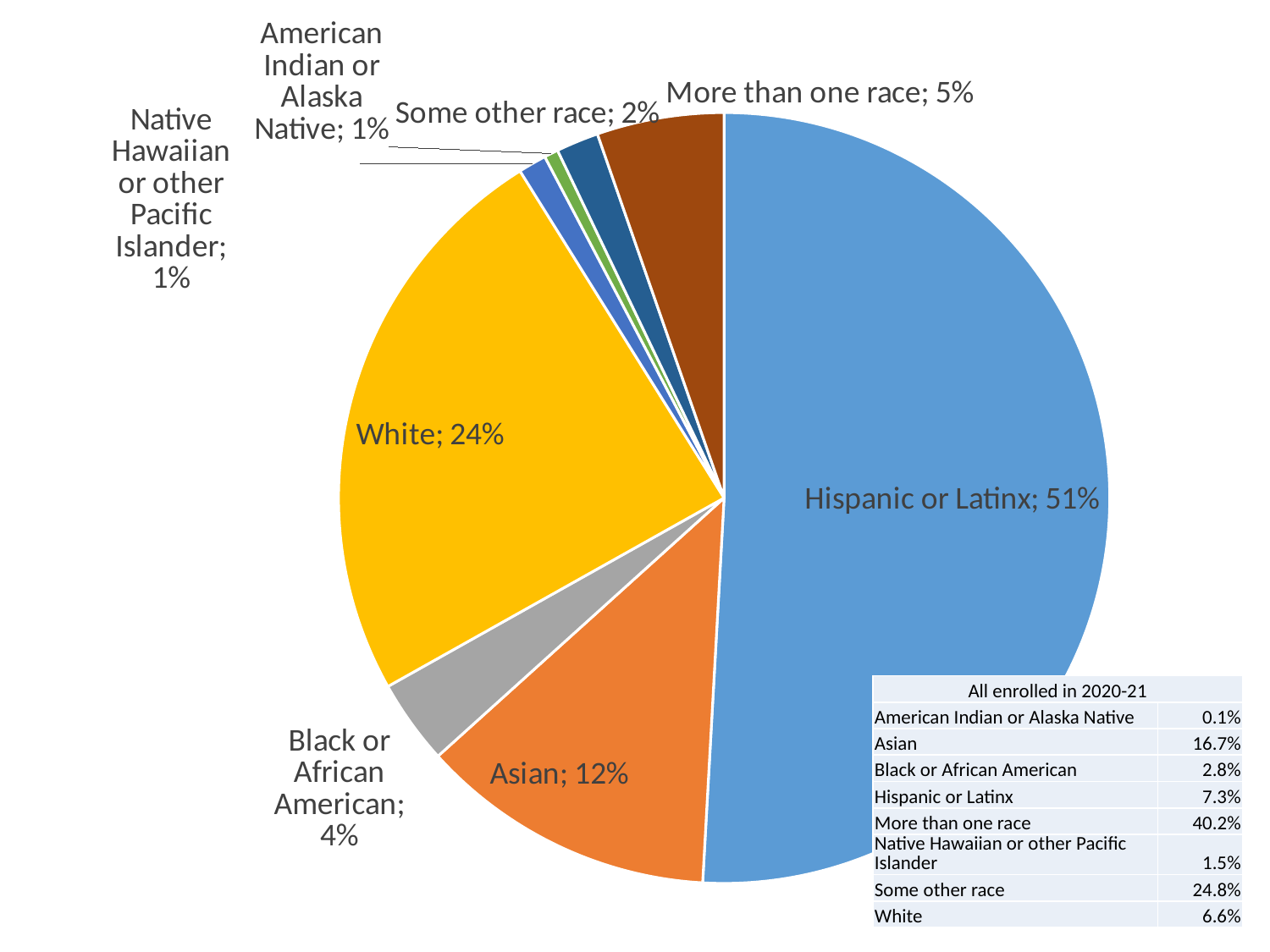
How many slices does the pie chart have? 8 What colour is the Hispanic or Latinx slice in the pie chart? blue What percentage does the pie chart label show for Asian? 12% What percentage does the pie chart label show for More than one race? 5% In the pie chart, which slice is larger: White or Asian? White According to the pie chart's data labels, what share of the pie is Hispanic or Latinx? 51% Which category has the largest slice in the pie chart? Hispanic or Latinx What percentage does the pie chart label show for Black or African American? 4% What kind of chart is shown on the slide? pie chart Based on the pie chart labels, what is the difference in percentage points between the White slice and the Asian slice? 12 What percentage does the pie chart label show for Some other race? 2% What percentage does the pie chart label show for White? 24%